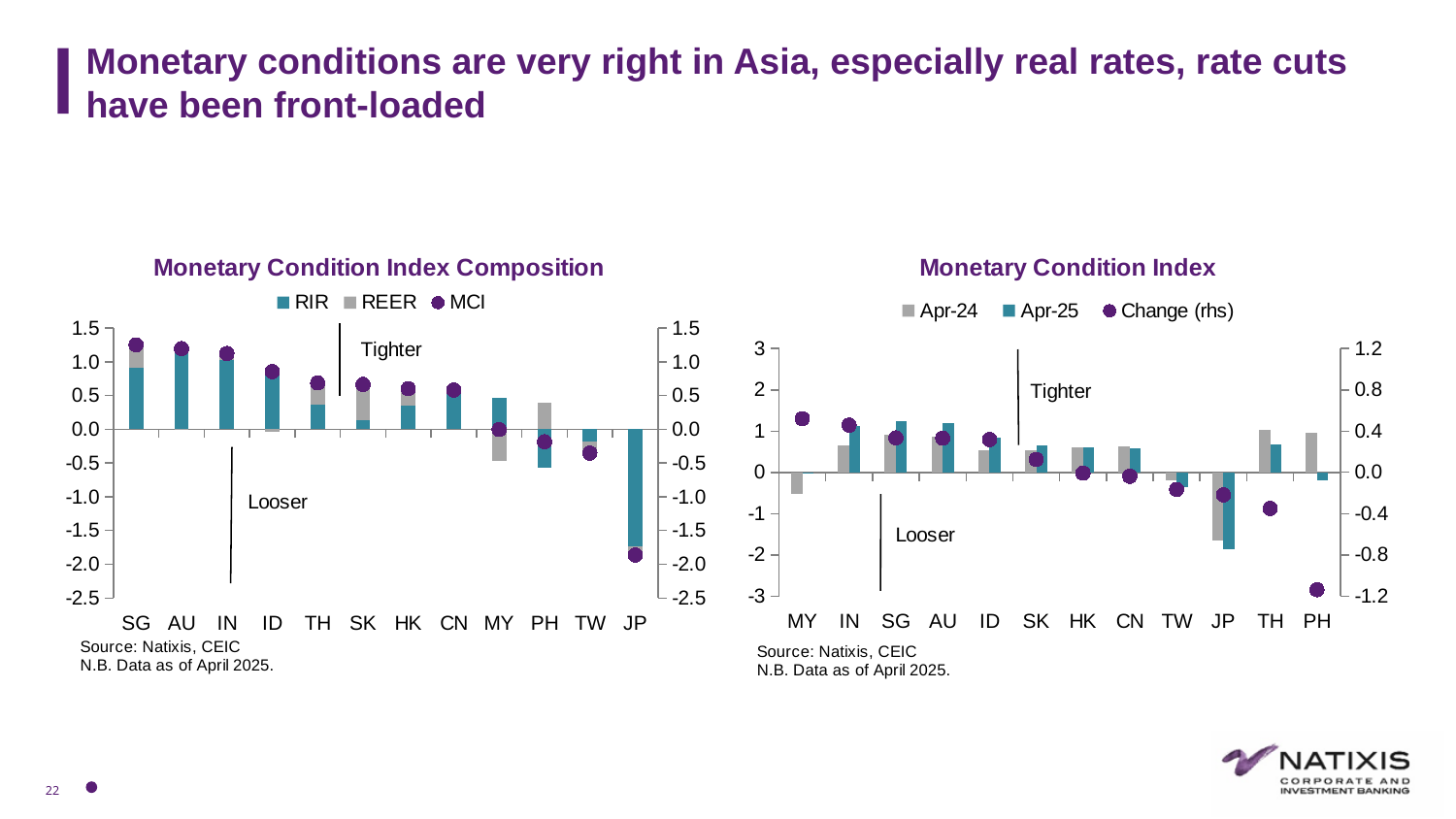
On the Monetary Condition Index Composition chart, which country has the highest MCI value? SG On the Monetary Condition Index chart, for TH, which is larger: the Apr-24 value or the Apr-25 value? Apr-24 On the Monetary Condition Index Composition chart, is the MCI value for JP greater or less than -1.5? less On the Monetary Condition Index chart, which country has the lowest Change (rhs) value? PH On the Monetary Condition Index Composition chart, which country has the lowest MCI value? JP On the Monetary Condition Index Composition chart, how many countries are shown on the x axis? 12 On the Monetary Condition Index Composition chart, what are the three legend entries? RIR, REER, MCI On the Monetary Condition Index chart, how many series does the legend list? 3 On the Monetary Condition Index chart, is the Apr-25 value for JP greater or less than -1? less On the Monetary Condition Index chart, which country has the lowest Apr-25 value? JP On the Monetary Condition Index Composition chart, is the MCI value for SG greater or less than 1.0? greater On the Monetary Condition Index Composition chart, how many series does the legend list? 3